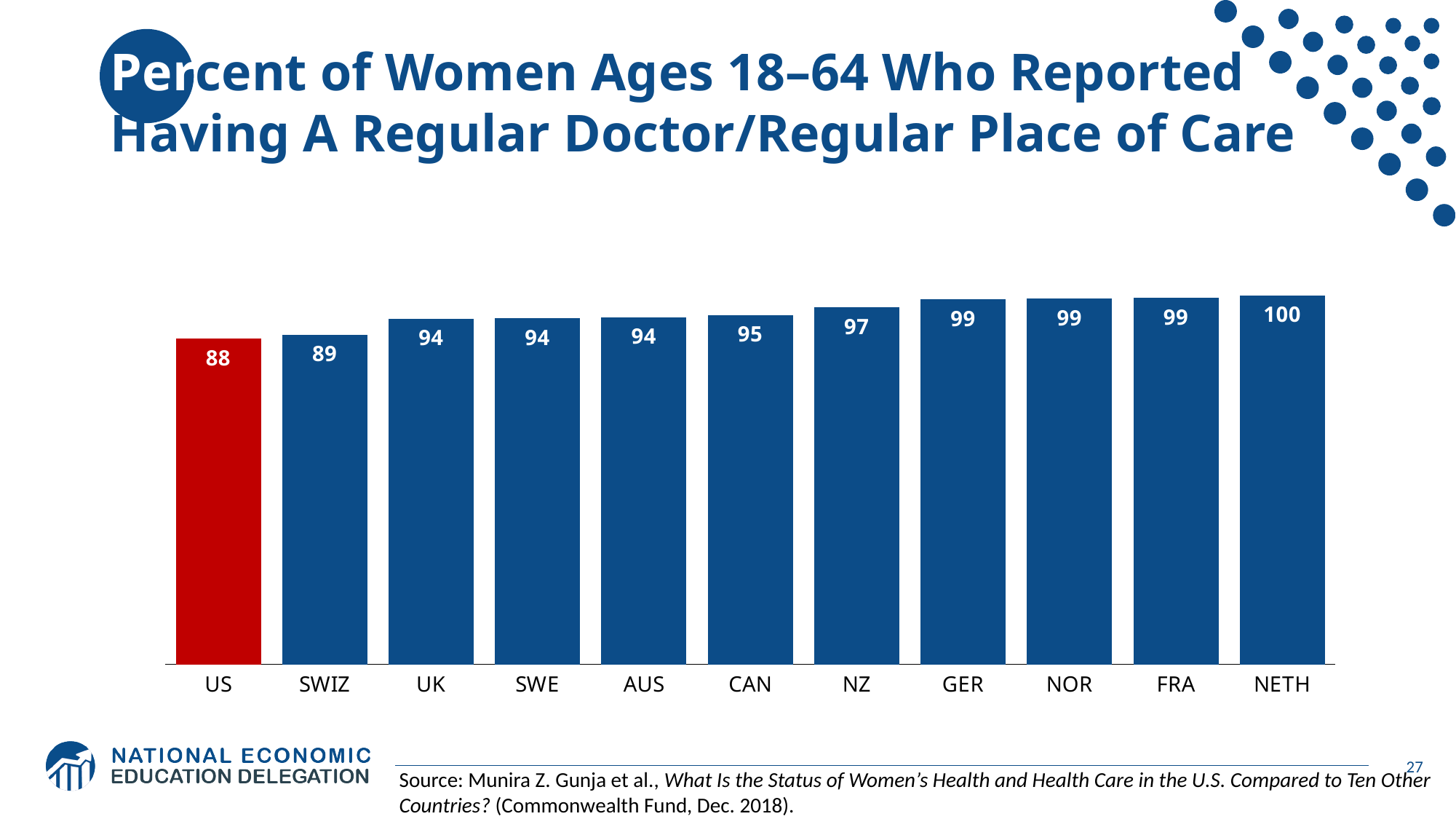
Which country has the lowest value? US What is the value for the US? 88 What is the difference between the values for SWIZ and the US? 1 Which country has the highest value? NETH Which has a larger value, UK or NZ? NZ What is the value for CAN? 95 How many countries are shown in the chart? 11 Do the values rise or fall from left to right along the x axis? rise What is the difference between the values for NETH and the US? 12 Which bar is coloured red instead of blue? US What is the value for NZ? 97 What kind of chart is this? bar chart